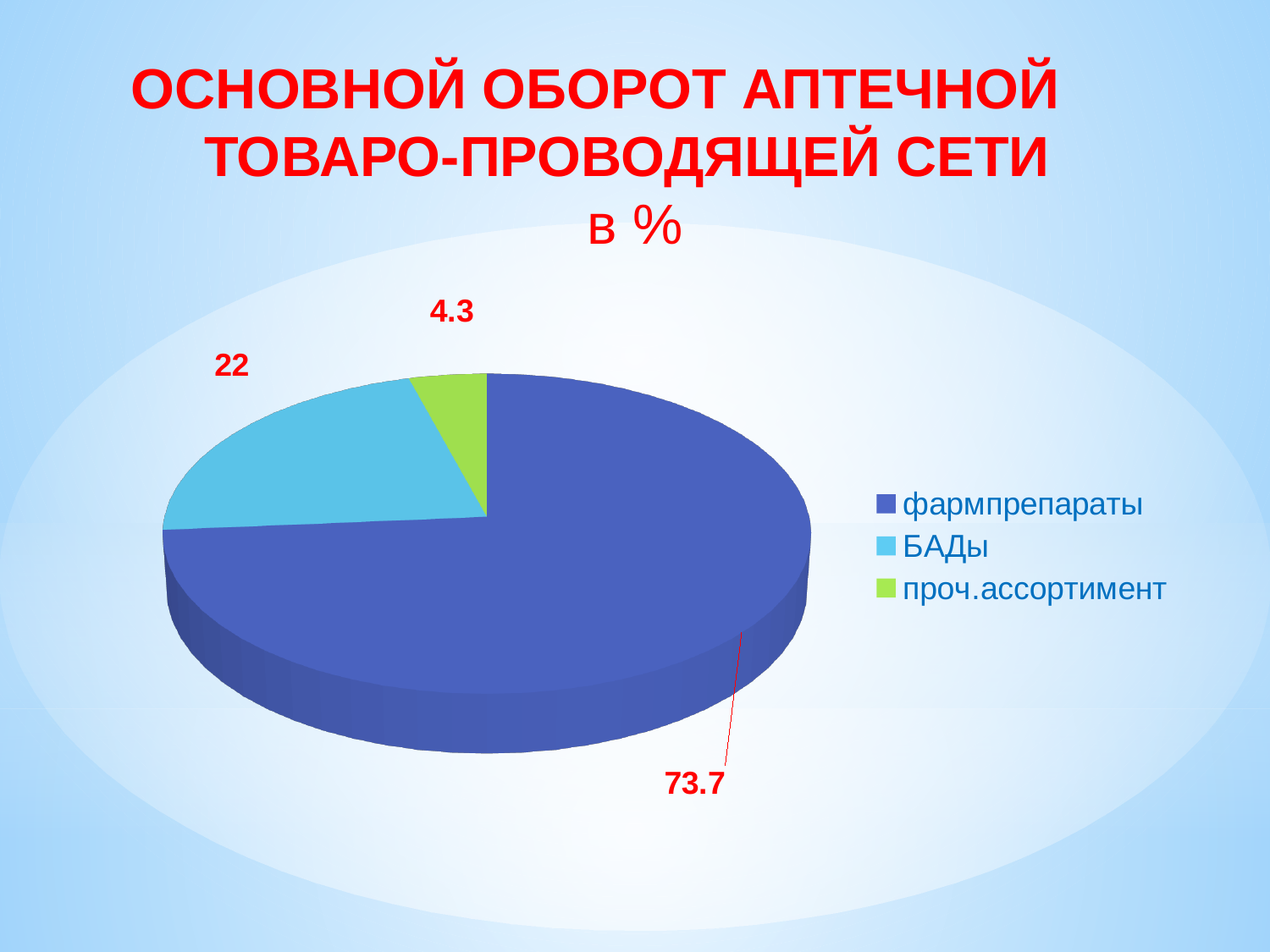
What kind of chart is shown on the slide? pie chart What is the value for проч.ассортимент? 4.3 How many categories does the pie chart show? 3 Which is larger, the value for БАДы or the value for проч.ассортимент? БАДы Which category has the smallest share of the pie? проч.ассортимент What colour is the slice for БАДы? light blue Which category has the largest share of the pie? фармпрепараты What is the value for БАДы? 22 What is the difference between the values for фармпрепараты and БАДы? 51.7 What is the value for фармпрепараты? 73.7 What is the title of the chart on the slide? ОСНОВНОЙ ОБОРОТ АПТЕЧНОЙ ТОВАРО-ПРОВОДЯЩЕЙ СЕТИ в % What is the difference between the values for БАДы and проч.ассортимент? 17.7